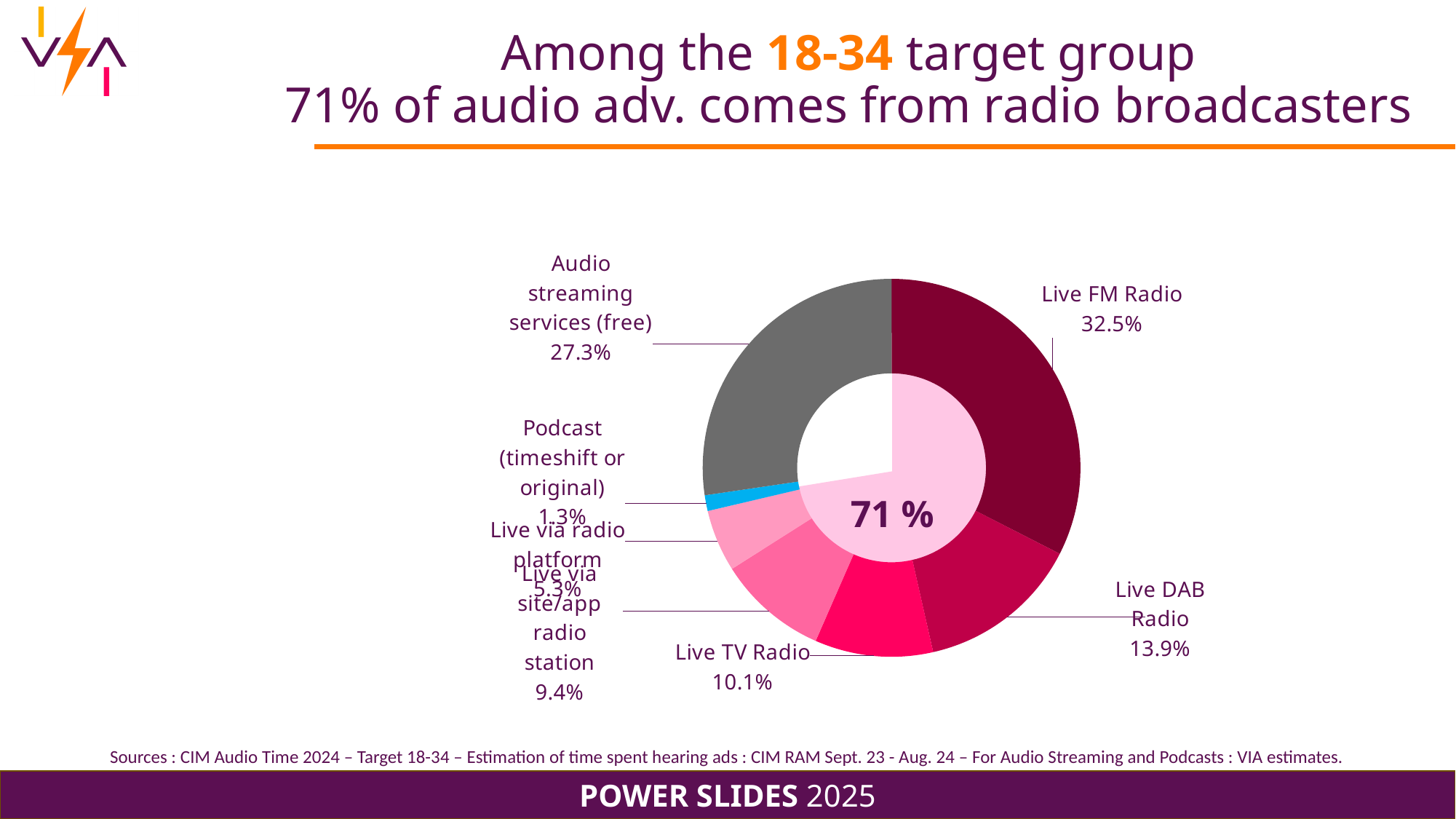
What percentage is shown for Podcast (timeshift or original)? 1.3% Which category has the smallest share of the pie? Podcast (timeshift or original) Which is larger, the share for Live DAB Radio or the share for Live TV Radio? Live DAB Radio What percentage is shown for Live DAB Radio? 13.9% What is the value for Live TV Radio? 10.1% What share of audio advertising comes from Live FM Radio? 32.5% How many categories are shown in the pie chart? 7 What kind of chart is shown on the slide? Pie chart (doughnut) What is the value shown for Audio streaming services (free)? 27.3% What percentage is printed in the centre of the doughnut chart? 71 % What is the difference between the Live FM Radio share and the Audio streaming services (free) share? 5.2% Which category has the largest share of the pie? Live FM Radio